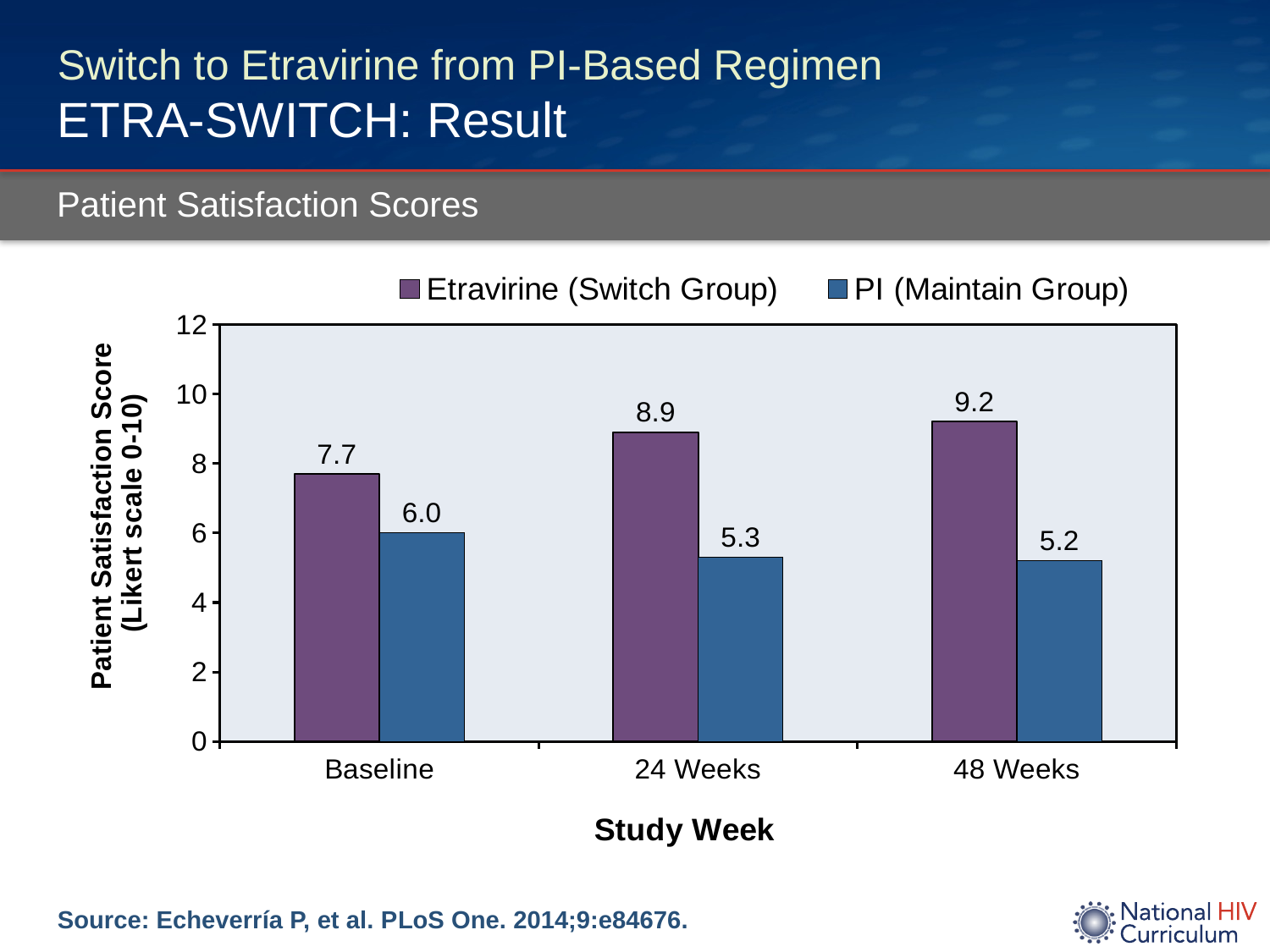
At which study week is the Etravirine (Switch Group) score highest? 48 Weeks Which group has the higher patient satisfaction score at Baseline? Etravirine (Switch Group) What is the patient satisfaction score for the Etravirine (Switch Group) at 24 Weeks? 8.9 How many study week categories are shown on the x axis? 3 Do the Etravirine (Switch Group) scores rise or fall from Baseline to 48 Weeks? rise What is the patient satisfaction score for the Etravirine (Switch Group) at Baseline? 7.7 What kind of chart is shown on the slide? bar chart What is the difference between the Etravirine (Switch Group) and PI (Maintain Group) scores at 48 Weeks? 4.0 What is the patient satisfaction score for the PI (Maintain Group) at 48 Weeks? 5.2 How many series does the legend list? 2 At which study week is the PI (Maintain Group) score lowest? 48 Weeks Is the PI (Maintain Group) score at 24 Weeks greater or less than 6? less